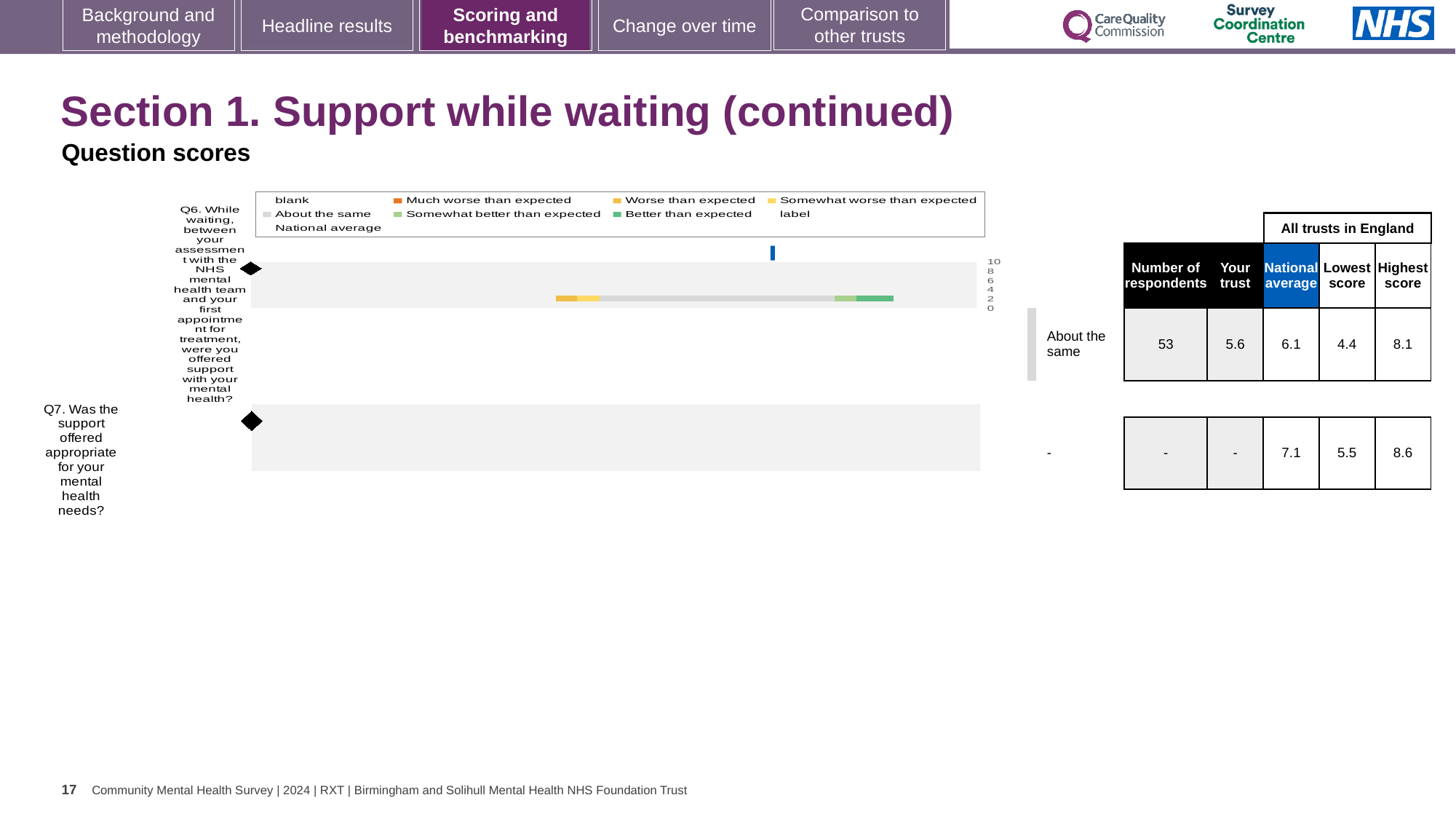
How many respondents answered Q6? 53 What is the difference between the highest and lowest scores across all trusts in England for Q7? 3.1 What is the highest score among all trusts in England for Q7 (was the support offered appropriate for your mental health needs)? 8.6 For Q6, which is larger: the trust's score or the national average? National average What benchmark category is shown for Q6 next to the chart? About the same What is the national average score for Q6? 6.1 What is the 'Your trust' score for Q6 (support while waiting between assessment and first appointment)? 5.6 How many questions are plotted on the chart? 2 What is the national average score for Q7? 7.1 What is the difference between the national average and the trust's score for Q6? 0.5 What is the lowest score among all trusts in England for Q6? 4.4 What kind of chart is used to show the question scores? Bar chart